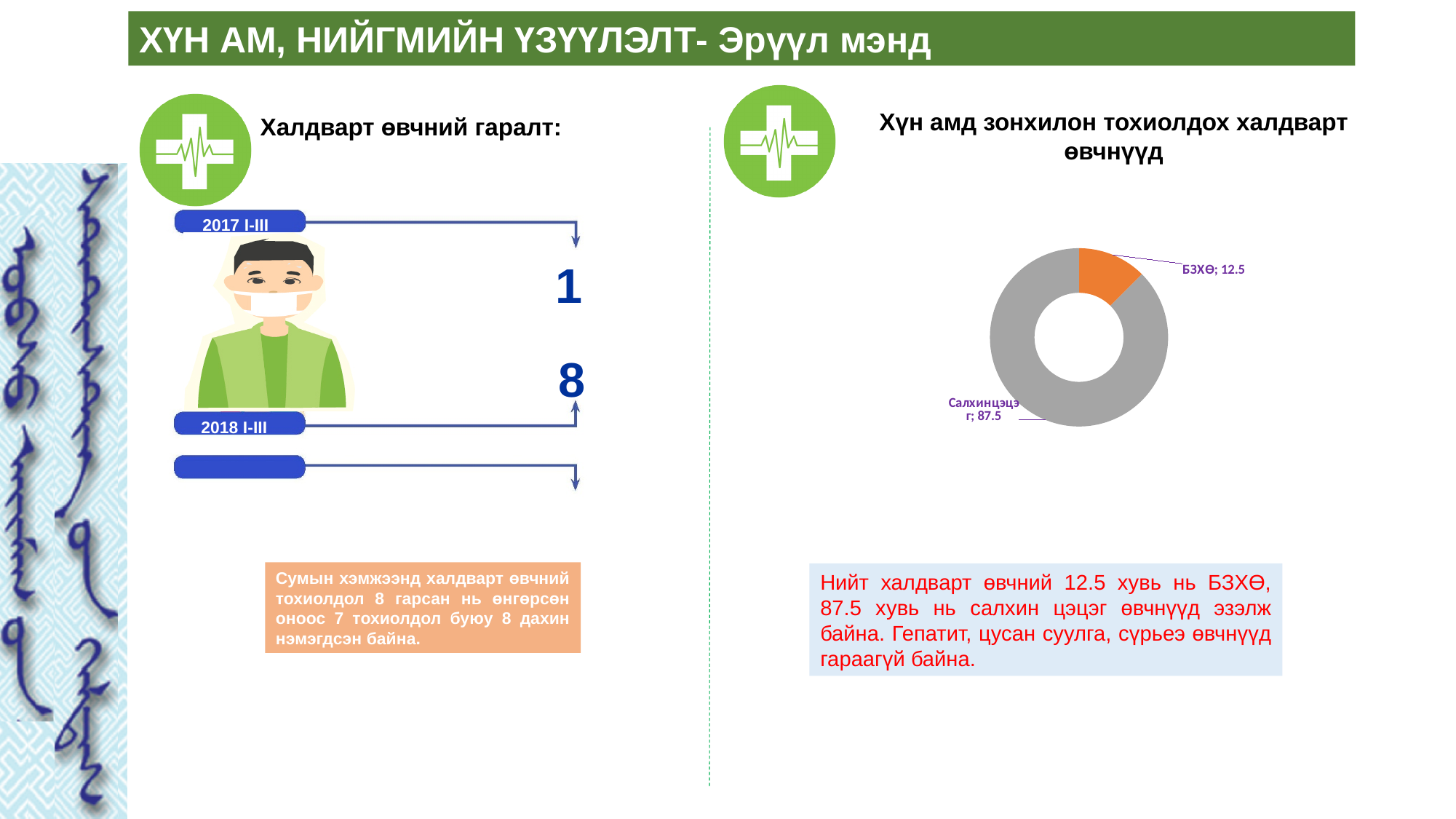
How many slices does the pie chart on the right of the slide have? 2 Which category has the largest slice in the pie chart on the right? Салхинцэцэг In the pie chart on the right, what is the difference between the values for Салхинцэцэг and БЗХӨ? 75 What share of the pie chart on the right does БЗХӨ account for? 12.5 What is the title above the pie chart on the right of the slide? Хүн амд зонхилон тохиолдох халдварт өвчнүүд In the pie chart on the right, what is the value shown for Салхинцэцэг? 87.5 In the pie chart on the right, which is larger: БЗХӨ or Салхинцэцэг? Салхинцэцэг What is the total of the two values shown in the pie chart on the right? 100 What colour is the БЗХӨ slice in the pie chart on the right? orange What kind of chart is shown under the title 'Хүн амд зонхилон тохиолдох халдварт өвчнүүд'? doughnut chart Which category has the smallest slice in the pie chart on the right? БЗХӨ In the pie chart on the right, what is the value shown for БЗХӨ? 12.5